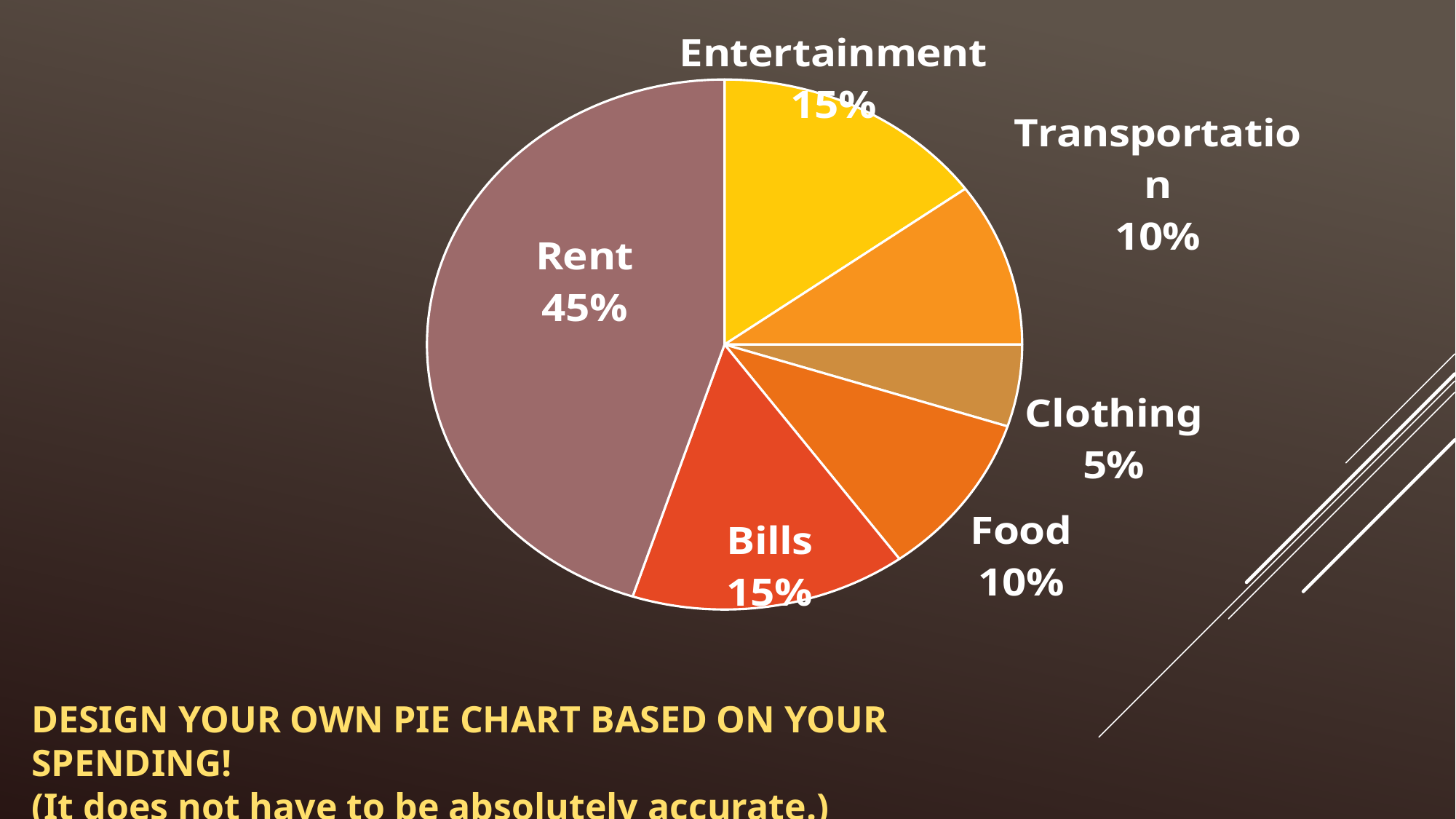
What percentage of spending goes to Rent? 45% What percentage of spending goes to Transportation? 10% Which is larger, the Entertainment share or the Food share? Entertainment Which category has the largest share of the pie? Rent What kind of chart is shown on the slide? Pie chart What is the combined share of Food and Transportation? 20% What is the difference between the Rent share and the Bills share? 30% How many slices does the pie chart have? 6 What colour is the Rent slice? Mauve (dusty pink) Which category has the smallest share of the pie? Clothing What percentage of spending goes to Clothing? 5% What percentage of spending goes to Bills? 15%